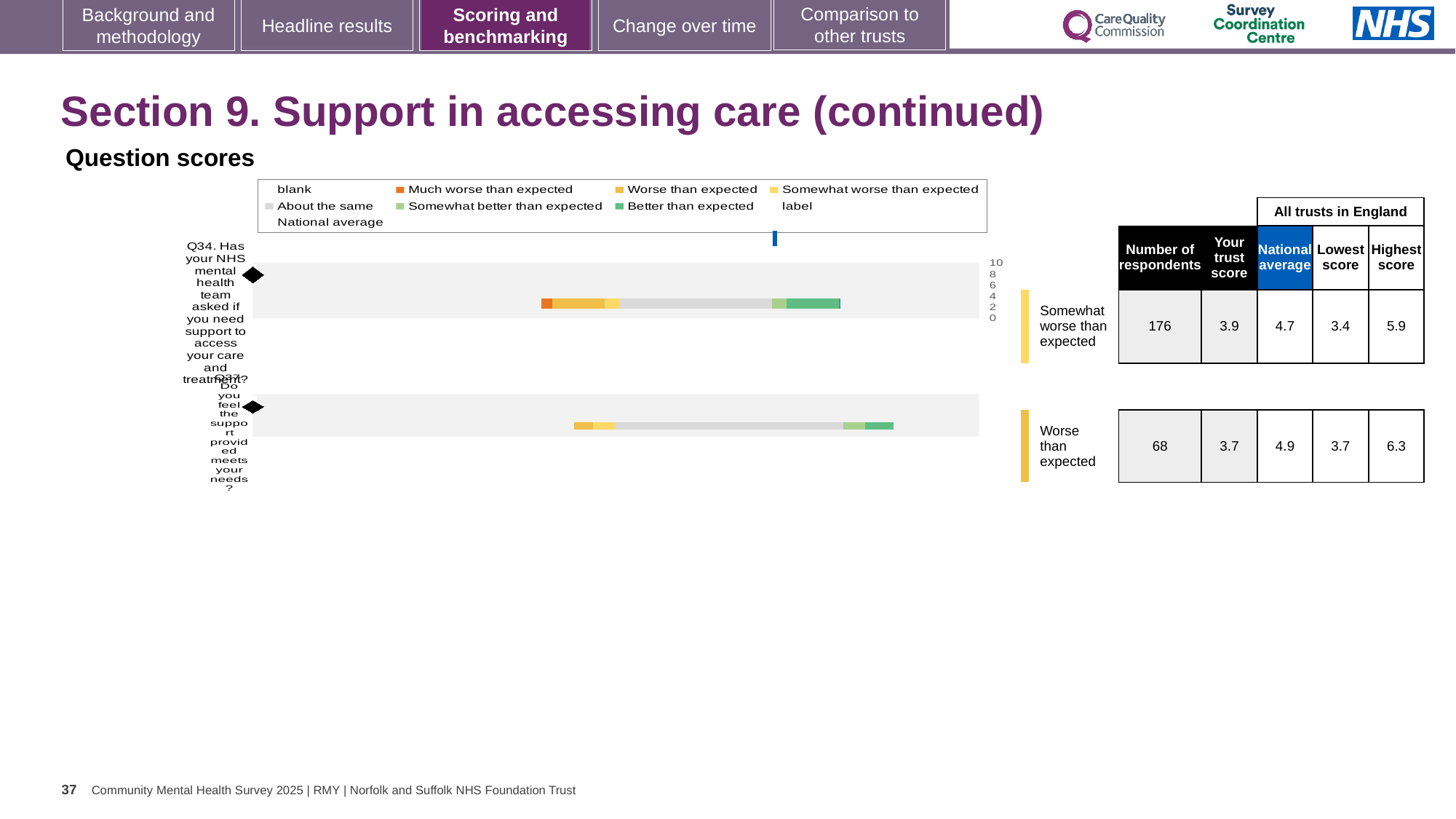
Which benchmarking category is Q34 assigned to? Somewhat worse than expected What is the lowest score across all trusts in England for Q34? 3.4 What is the difference between the highest score for Q37 and the highest score for Q34? 0.4 Which is larger for Q34, the trust score or the national average? national average What is the national average score for Q37 (Do you feel the support provided meets your needs)? 4.9 How many questions are plotted in the question scores chart? 2 Which benchmarking category is Q37 assigned to? Worse than expected What is the difference between the national average and the trust score for Q37? 1.2 What is the trust score for Q34 (Has your NHS mental health team asked if you need support to access your care and treatment)? 3.9 What kind of chart is used to show the question scores on this slide? bar chart What is the number of respondents for Q34? 176 What is the highest score across all trusts in England for Q37? 6.3